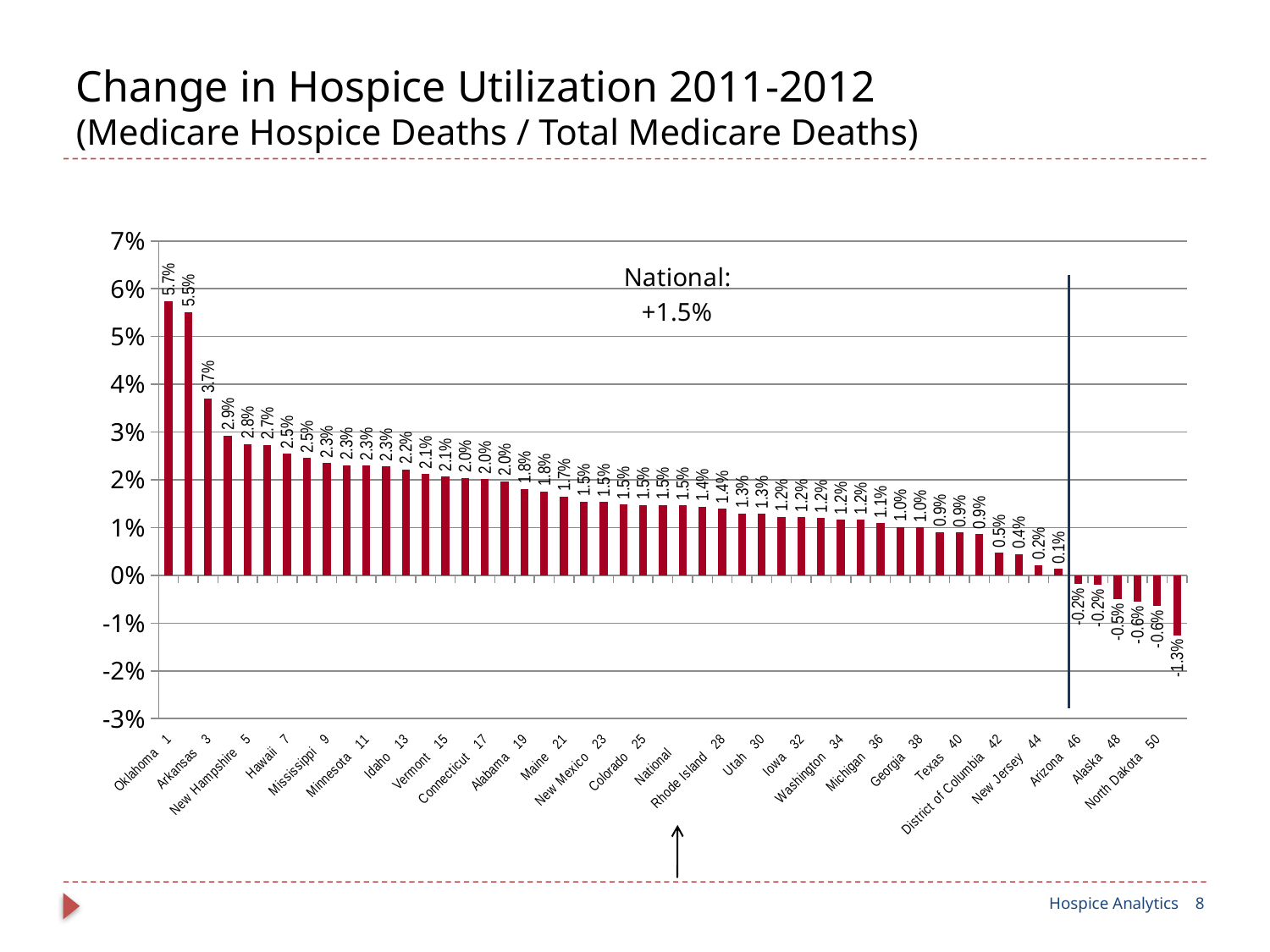
What is the difference between the values for Oklahoma and Arkansas? 2.0% What is the change in hospice utilization for North Dakota? -0.6% Which is larger, the value for Oklahoma or the national value? Oklahoma What is the lowest value plotted on the chart? -1.3% Do the values rise or fall moving from left to right along the x axis? fall What kind of chart is shown on the slide? bar chart What is the change in hospice utilization for Arkansas? 3.7% Which state has the highest change in hospice utilization? Oklahoma What is the change in hospice utilization for Oklahoma? 5.7% What is the title of the chart on the slide? Change in Hospice Utilization 2011-2012 Is the value for Oklahoma greater or less than 5%? greater What is the national change in hospice utilization shown on the chart? +1.5%